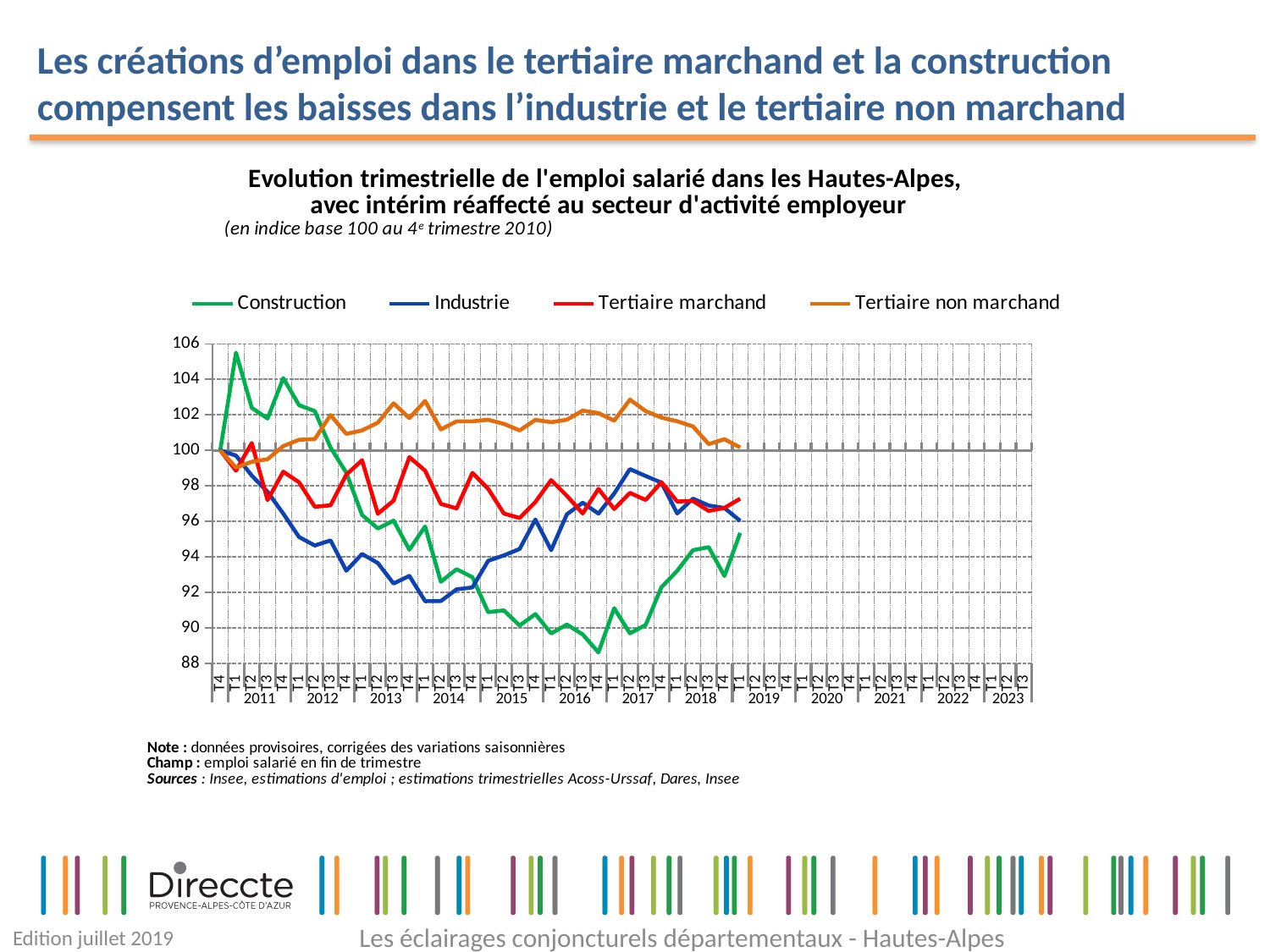
Is the value for Industrie at T1 2014 greater or less than 92? less Is the value for Tertiaire non marchand at T2 2017 greater or less than 102? greater Does the Construction series rise or fall overall between T1 2011 and T4 2016? fall What kind of chart is shown on the slide? line chart How many series does the legend list? 4 Is the value for Construction at T4 2016 greater or less than 90? less What is the base period of the index used in the chart, as stated under the title? 4e trimestre 2010 Which series has the highest value at T1 2019, the last plotted quarter? Tertiaire non marchand Which series has the lowest value at T4 2016? Construction Which series is drawn in green? Construction